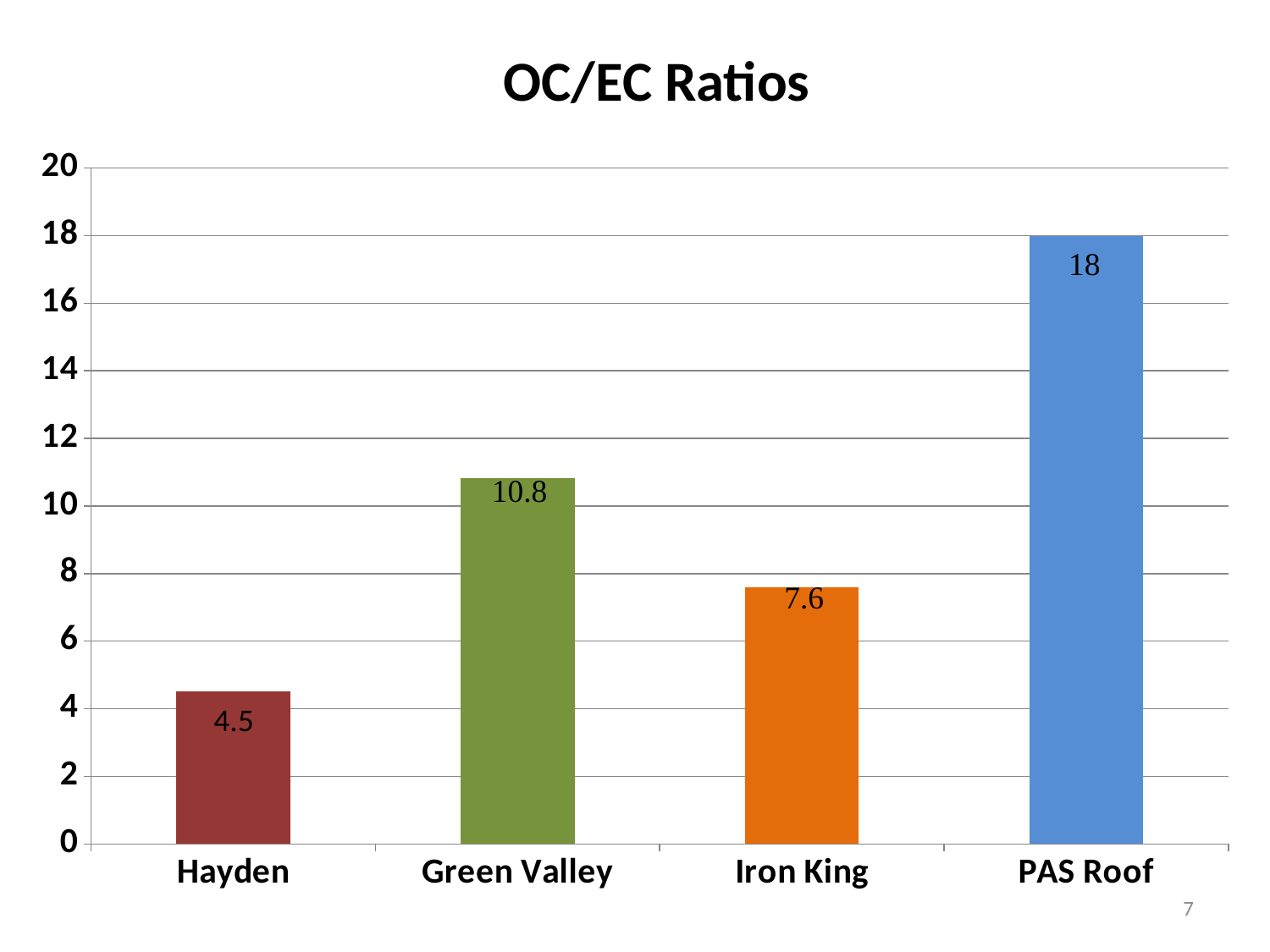
What is the OC/EC ratio for Hayden? 4.5 Which site has the lowest OC/EC ratio? Hayden What is the OC/EC ratio for Iron King? 7.6 Which has a larger OC/EC ratio, Green Valley or Iron King? Green Valley Which site has the highest OC/EC ratio? PAS Roof What is the difference between the OC/EC ratios of PAS Roof and Hayden? 13.5 What is the difference between the OC/EC ratios of Green Valley and Iron King? 3.2 How many sites are shown in the chart? 4 What is the OC/EC ratio for Green Valley? 10.8 Is the OC/EC ratio for Iron King greater or less than 8? less What is the OC/EC ratio for PAS Roof? 18 What type of chart is shown on the slide? Bar chart